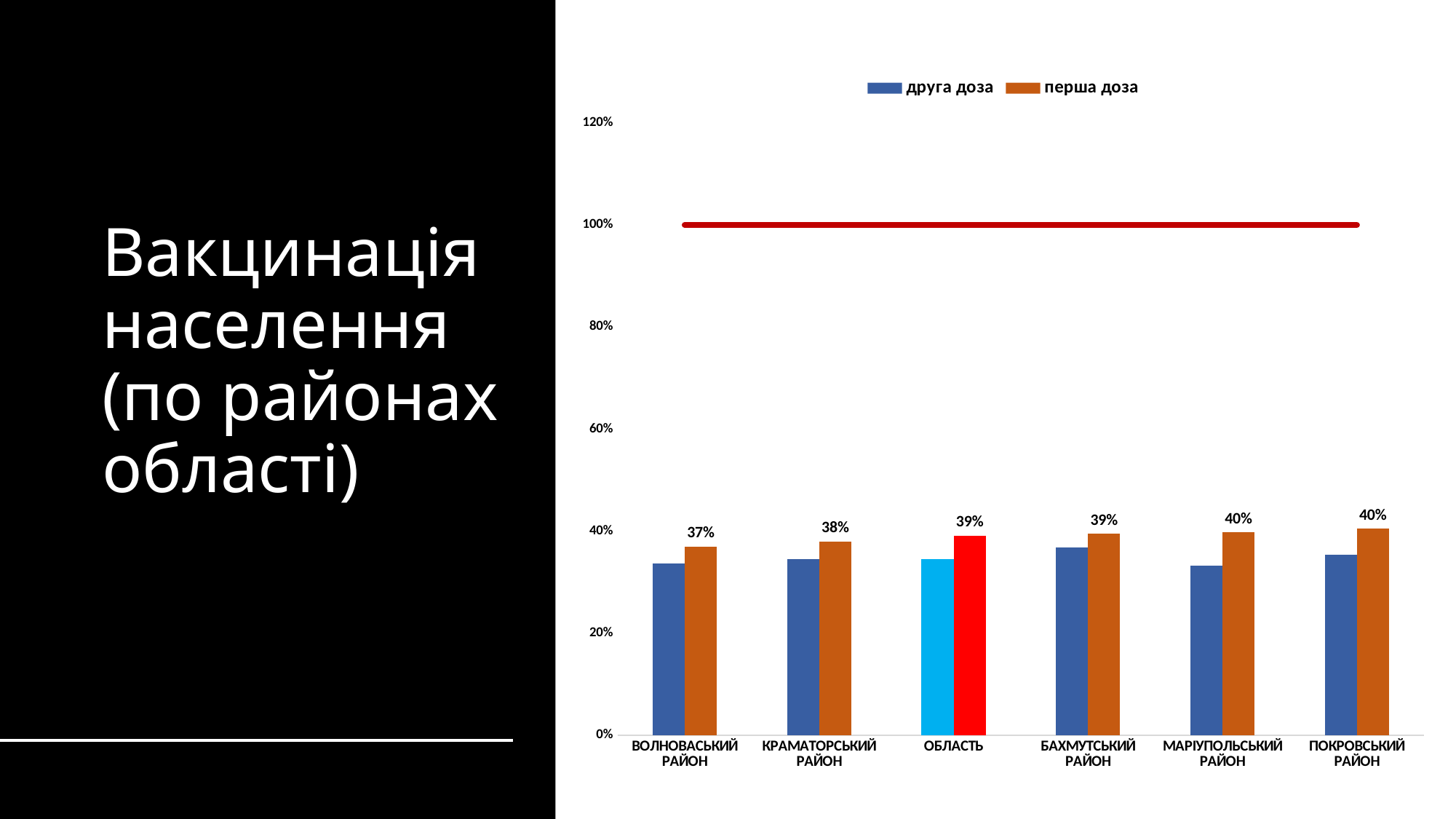
What is the value of the перша доза bar for Область? 39% What is the difference between the перша доза values for Покровський район and Волноваський район? 3% How many series does the legend list? 2 What kind of chart is shown on the slide? bar chart Is the друга доза value for Волноваський район greater or less than 40%? less Which is larger: the перша доза value for Маріупольський район or for Краматорський район? Маріупольський район Which category has the lowest перша доза value? Волноваський район What is the value of the перша доза bar for Покровський район? 40% What is the value of the перша доза bar for Краматорський район? 38% At what value on the y axis is the red horizontal line drawn? 100% How many categories are shown on the x axis? 6 What is the value of the перша доза bar for Волноваський район? 37%